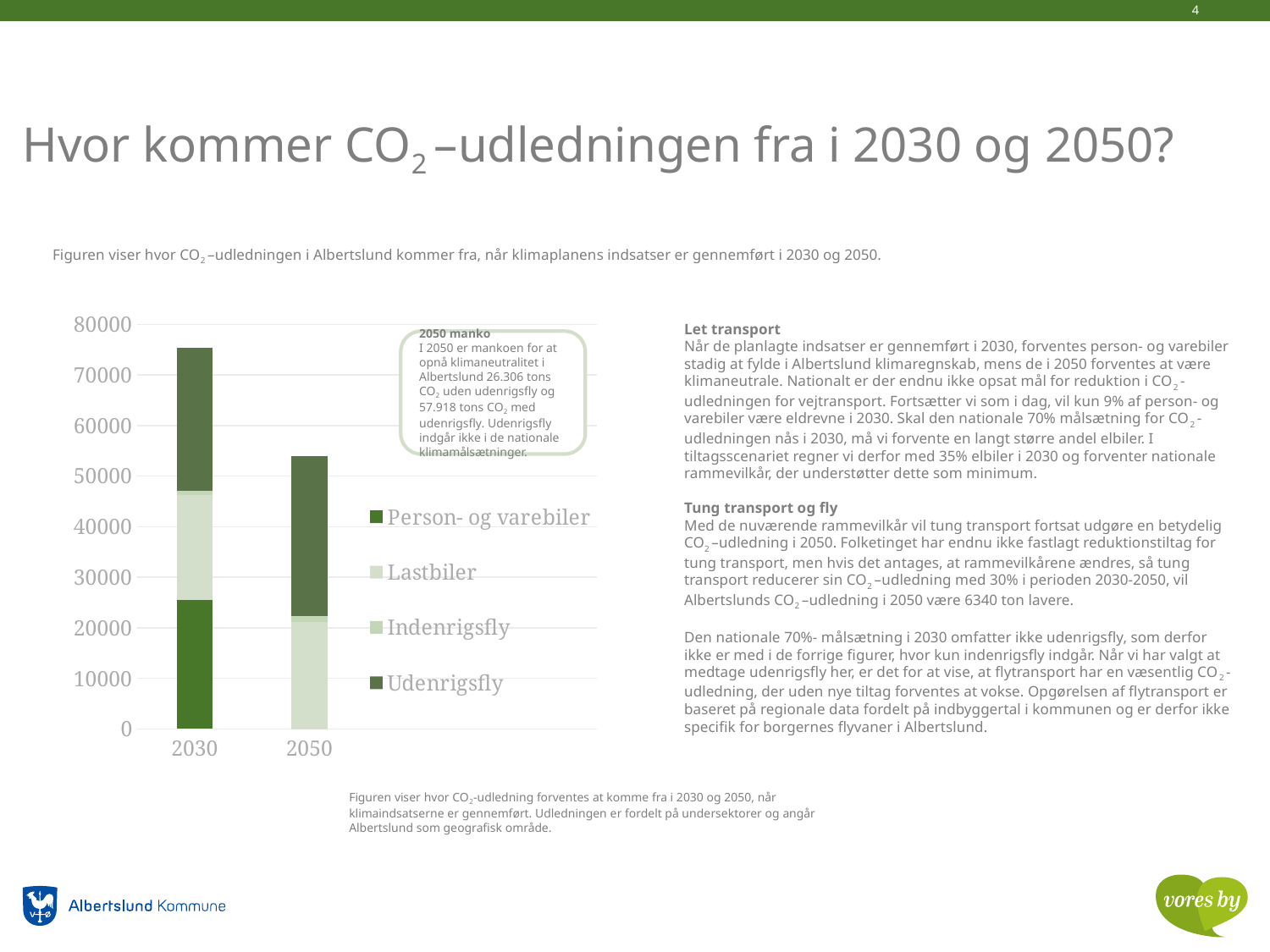
Is the total value of the 2030 bar greater or less than 70000? greater Which year has the taller stacked bar, 2030 or 2050? 2030 Is the total value of the 2050 bar greater or less than 50000? greater How many series does the chart's legend list? 4 Which category has the lowest total bar? 2050 Which two years are shown as categories on the x axis? 2030 and 2050 What kind of chart is shown on the slide? Stacked bar chart Which series are listed in the chart's legend? Person- og varebiler, Lastbiler, Indenrigsfly, Udenrigsfly Is the total value of the 2050 bar greater or less than 60000? less How many categories are shown on the x axis of the chart? 2 Which category has the highest total bar? 2030 Do the total bar values rise or fall from 2030 to 2050? fall